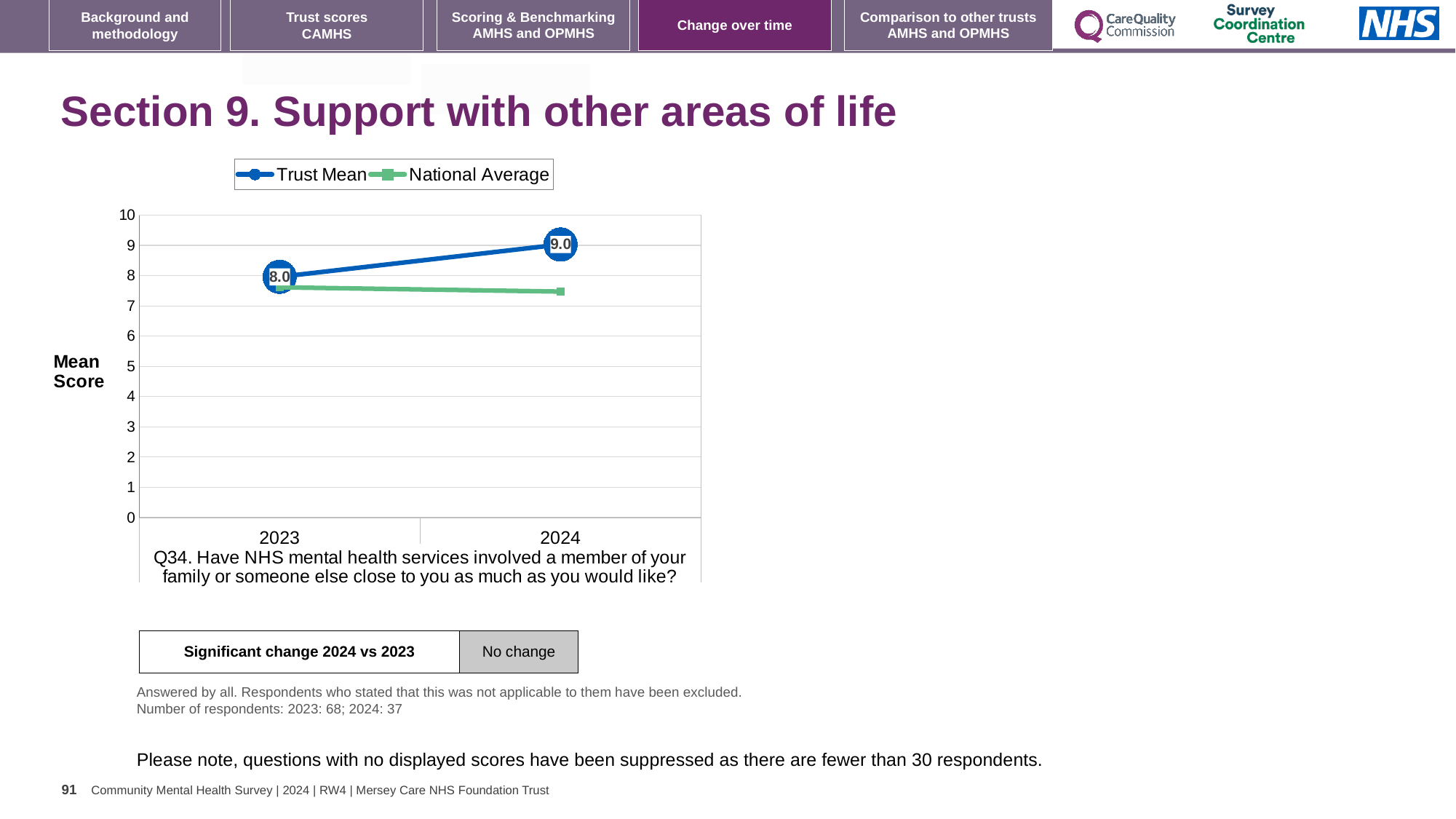
In which year is the Trust Mean lowest? 2023 By how much did the Trust Mean change from 2023 to 2024? 1.0 How many years are plotted on the x axis? 2 Does the Trust Mean rise or fall from 2023 to 2024? Rise What is the Trust Mean score for 2023? 8.0 Is the National Average value for 2024 greater or less than 8? less Is the National Average value for 2023 greater or less than 7? greater What kind of chart is shown on the slide? Line chart How many series does the legend list? 2 What is the Trust Mean score for 2024? 9.0 In 2024, which is larger: the Trust Mean or the National Average? Trust Mean In which year is the Trust Mean highest? 2024